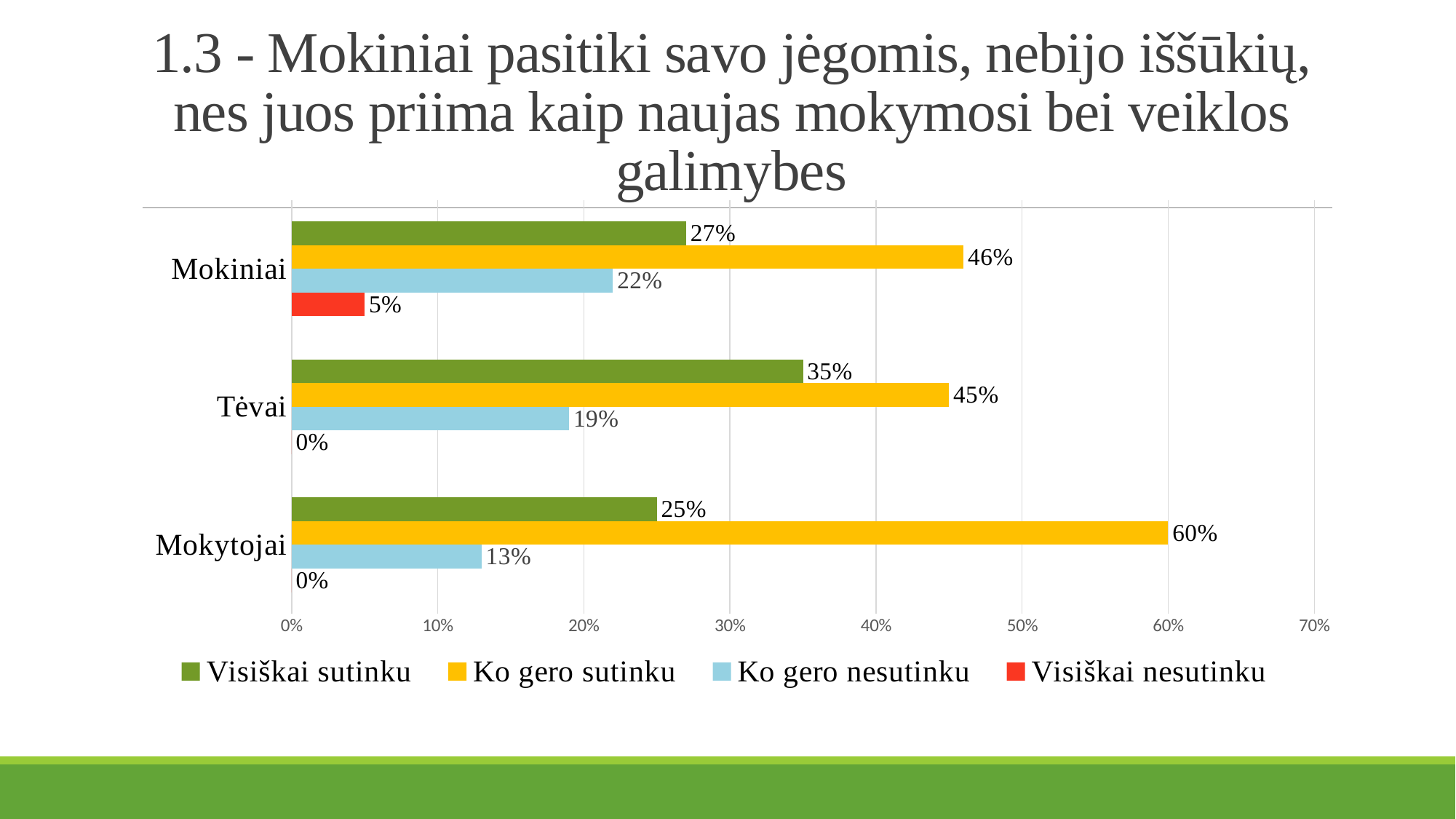
What kind of chart is shown on the slide? bar chart What is the difference between the "Visiškai sutinku" values for Tėvai and Mokytojai? 10% What is the value of "Visiškai nesutinku" for Mokiniai? 5% Is the value of "Ko gero sutinku" for Mokytojai greater or less than 50%? greater Which category has the lowest value for "Ko gero nesutinku"? Mokytojai How many series does the legend list? 4 How many categories are shown on the y axis? 3 What is the value of "Ko gero sutinku" for Mokytojai? 60% What is the value of "Ko gero nesutinku" for Tėvai? 19% Which colour represents "Visiškai nesutinku" in the legend? red Which category has the highest value for "Ko gero sutinku"? Mokytojai Which is larger: "Ko gero sutinku" for Mokiniai or "Ko gero sutinku" for Tėvai? Mokiniai